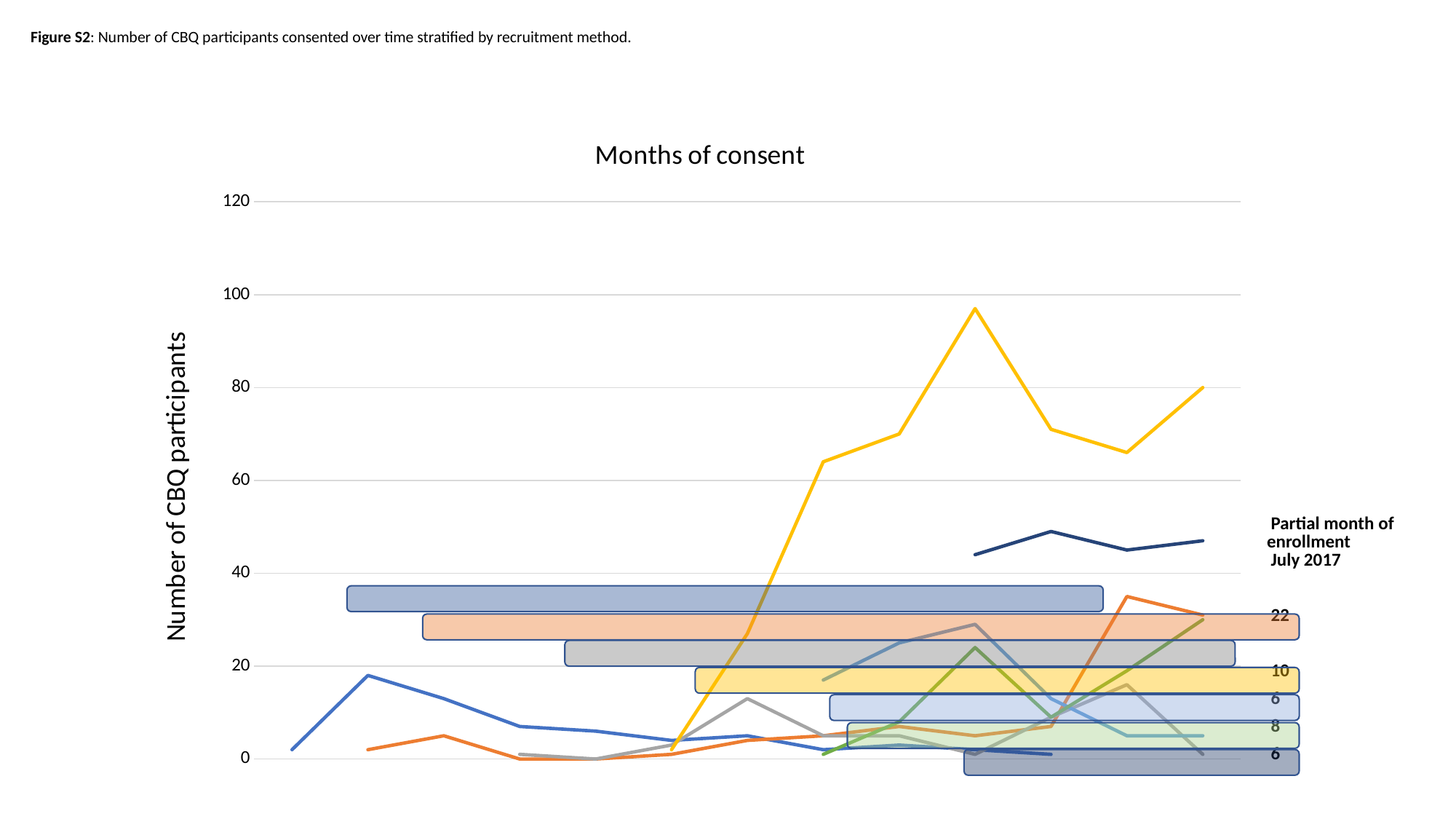
Which line is higher at its peak, the yellow line or the dark navy line? the yellow line Is the peak value of the yellow line greater or less than 100? less What is the highest value shown on the vertical axis? 120 Is the peak value of the blue line at the far left of the chart greater or less than 20? less Is the highest value of the dark navy line greater or less than 40? greater Does the yellow line rise or fall between its first point and its peak? rise What is the label on the vertical axis of the chart? Number of CBQ participants What kind of chart is shown on the slide? line chart Which coloured line reaches the highest value on the chart? the yellow line What is the title of the chart? Months of consent